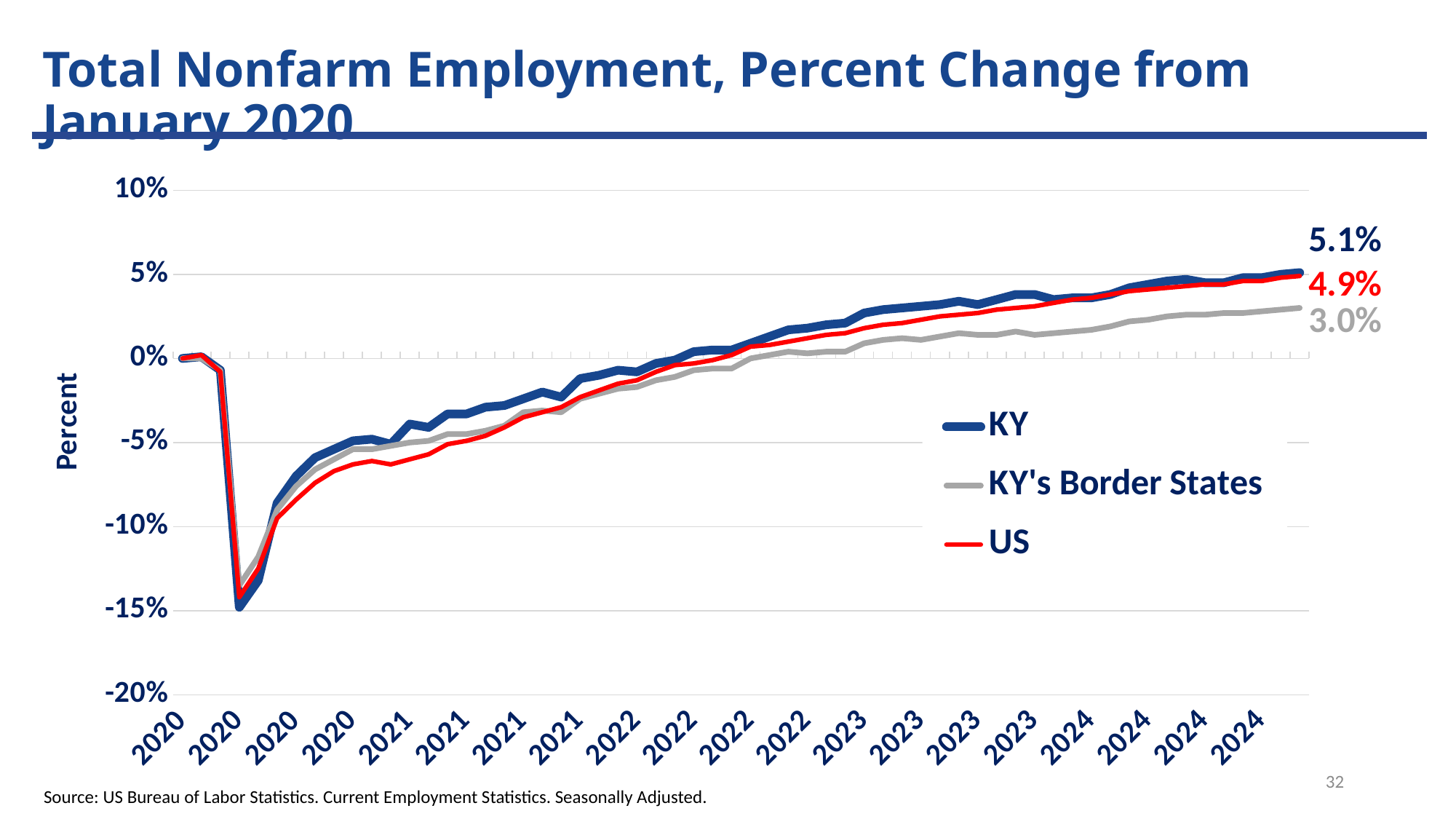
Which series has the lowest labelled value at the end of the chart? KY's Border States What kind of chart is shown on the slide? line chart After the sharp drop in 2020, do the series generally rise or fall over the rest of the chart? rise What is the final labelled value for the KY's Border States series? 3.0% What is the final labelled value for the KY series? 5.1% Which series has the highest labelled value at the end of the chart? KY Is the lowest point of the KY line in 2020 greater or less than -10%? less What is the final labelled value for the US series? 4.9% How many series does the legend list? 3 What colour is the US line in the legend? red At the end of the chart, which is larger: the labelled value for KY or for US? KY What is the difference between the final labelled values for KY and KY's Border States? 2.1 percentage points